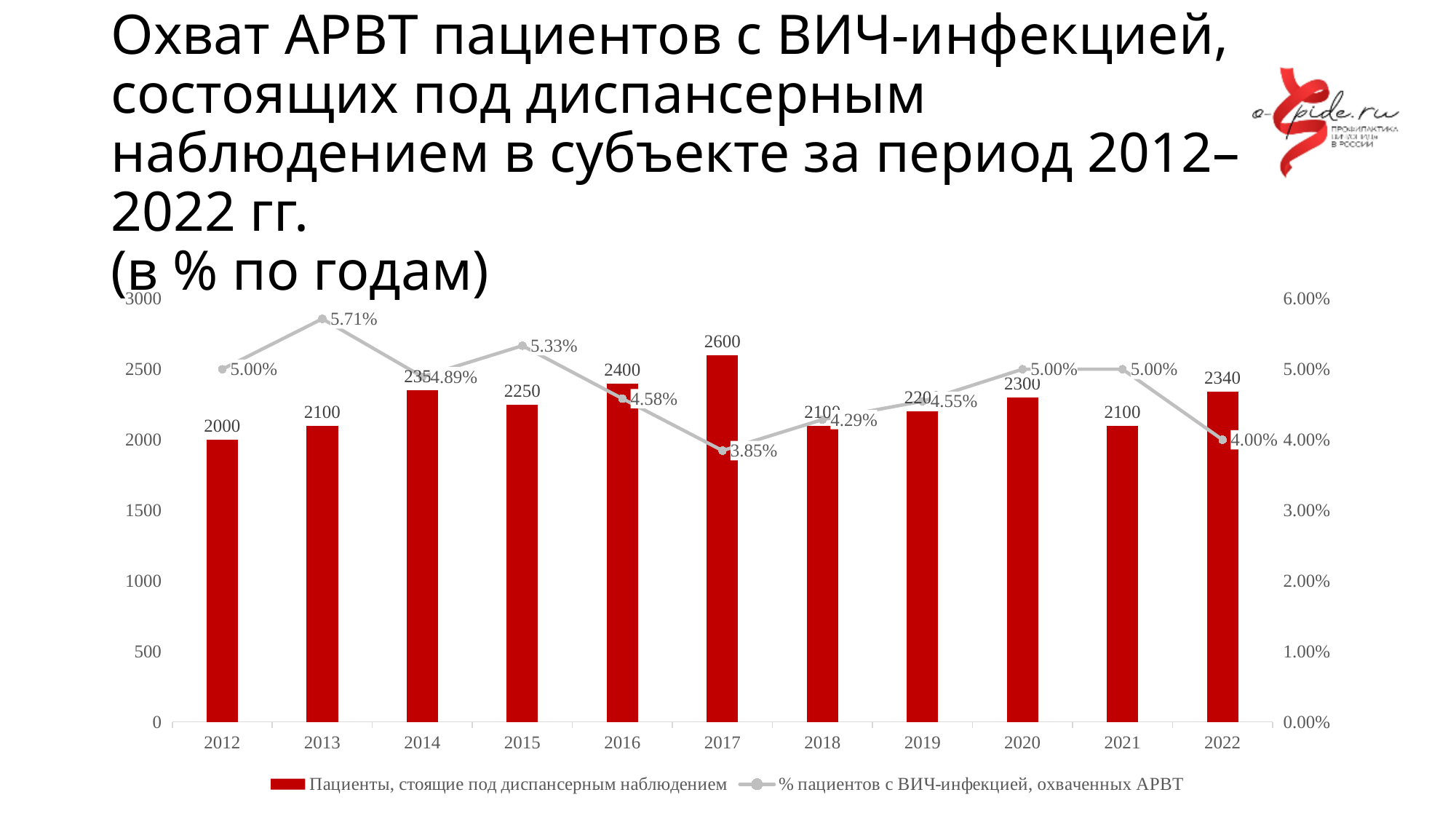
How many series does the legend list? 2 What colour are the bars in the chart? Red In which year is the number of patients under dispensary observation highest? 2017 What percentage of patients with HIV infection were covered by ART in 2017? 3.85% Which year has more patients under dispensary observation, 2016 or 2021? 2016 What is the difference between the number of patients under dispensary observation in 2017 and in 2012? 600 What is the number of patients under dispensary observation in 2017? 2600 Is the percentage of patients covered by ART in 2015 greater or less than 5.00%? greater What is the number of patients under dispensary observation in 2022? 2340 How many years are shown on the x axis of the chart? 11 What percentage of patients with HIV infection were covered by ART in 2013? 5.71% In which year is the percentage of patients covered by ART lowest? 2017